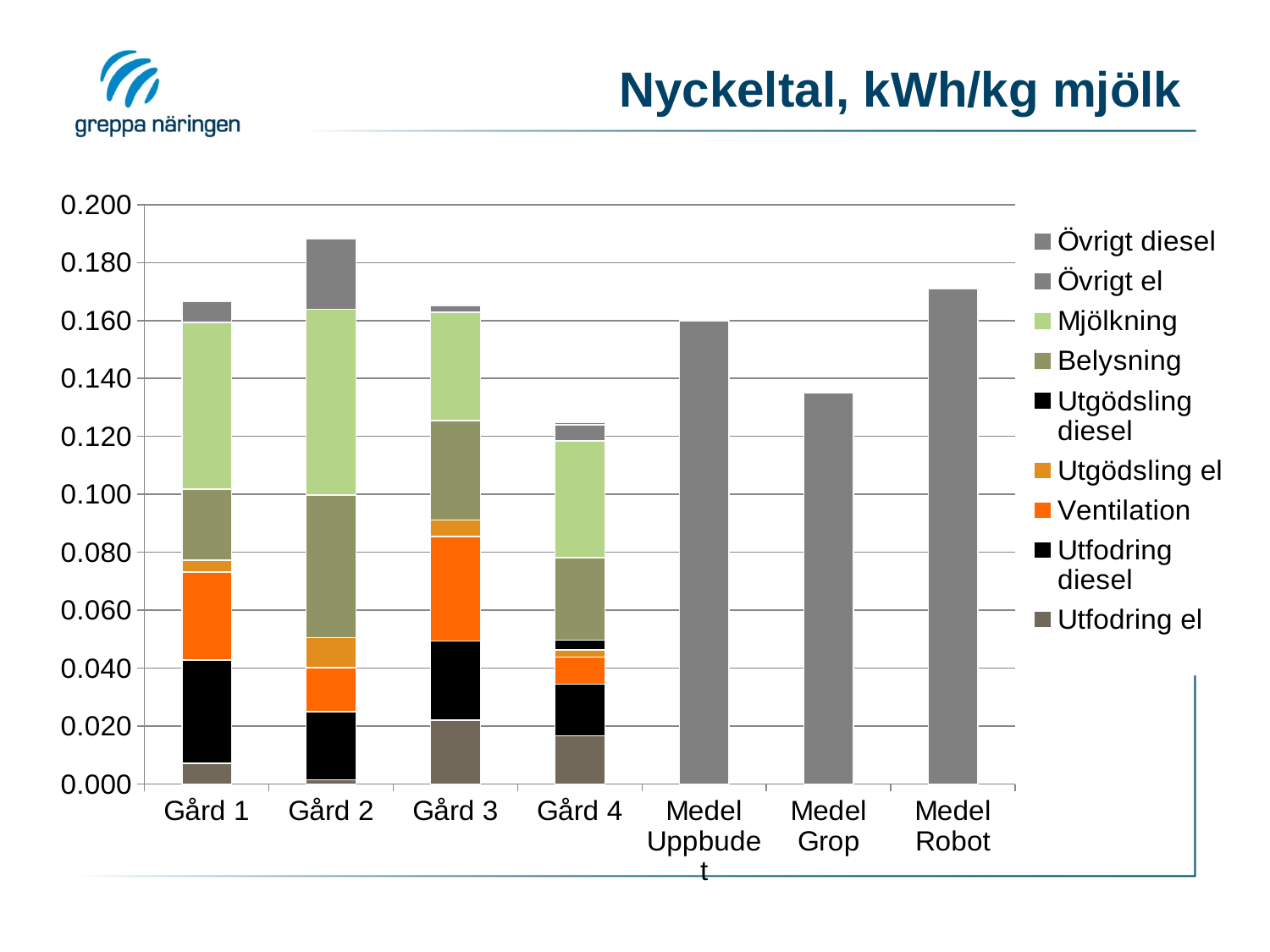
Which legend entry is shown in light green? Mjölkning Is the total bar for Gård 4 greater or less than 0.140? less Which category has the highest total bar? Gård 2 What is the title of the chart? Nyckeltal, kWh/kg mjölk Is the value for Medel Robot greater or less than 0.160? greater Is the value for Medel Uppbudet greater or less than 0.140? greater How many series does the legend list? 9 What kind of chart is shown on the slide? Stacked bar chart How many categories are shown along the x axis? 7 Which category has the lowest total bar? Gård 4 Which is larger, the total bar for Gård 2 or the bar for Medel Robot? Gård 2